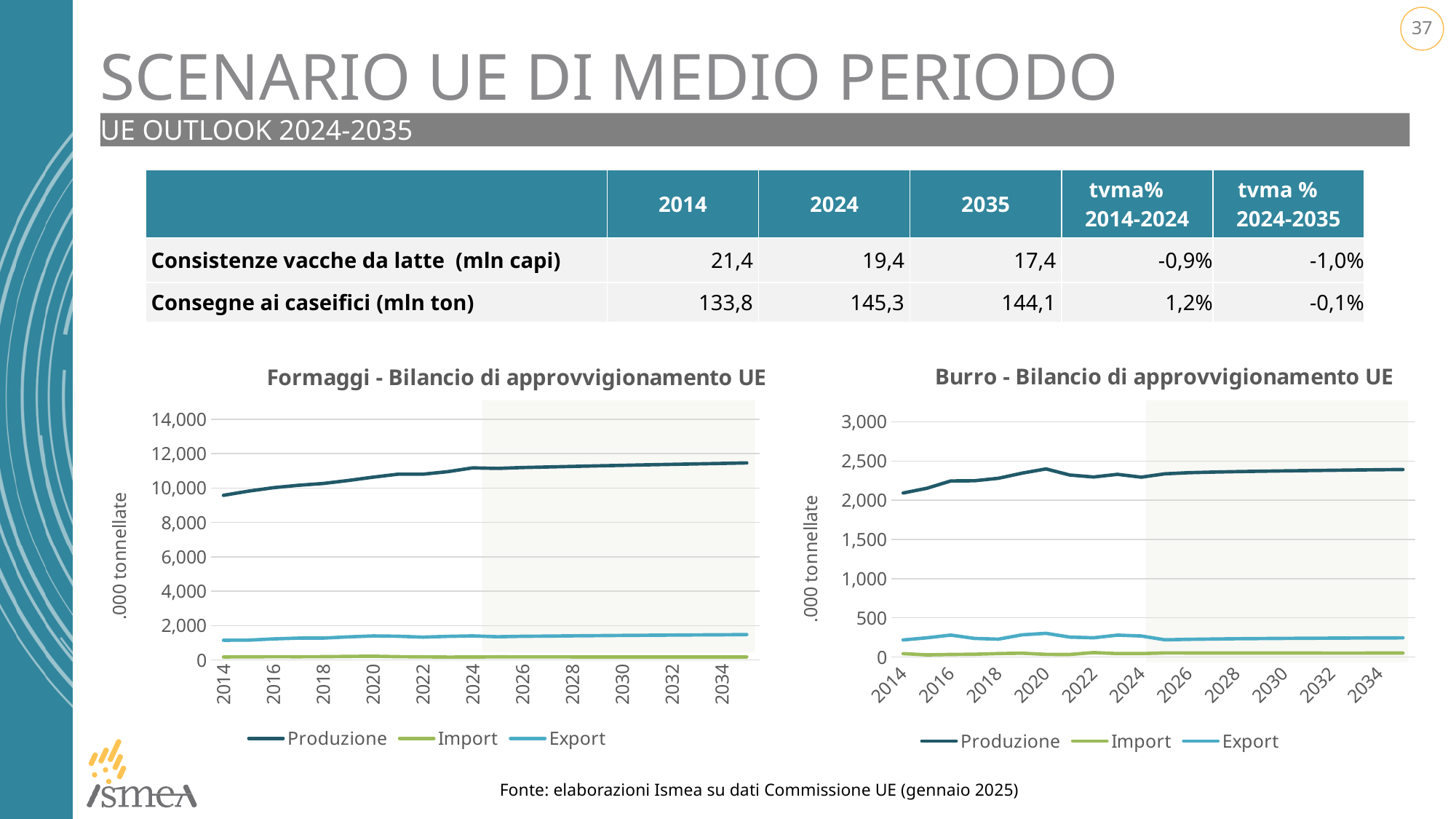
In the 'Formaggi - Bilancio di approvvigionamento UE' chart, is the Produzione value for 2034 greater or less than 10,000? greater In the 'Formaggi - Bilancio di approvvigionamento UE' chart, does the Produzione series rise or fall from 2014 to 2034? rise How many series does the legend of the 'Burro - Bilancio di approvvigionamento UE' chart list? 3 In the 'Burro - Bilancio di approvvigionamento UE' chart, is the Produzione value for 2014 greater or less than 2,500? less In the 'Burro - Bilancio di approvvigionamento UE' chart, which series has the lowest values throughout the period? Import In the 'Formaggi - Bilancio di approvvigionamento UE' chart, is the Produzione value for 2014 greater or less than 10,000? less What is the title of the chart on the left of the slide? Formaggi - Bilancio di approvvigionamento UE In the 'Formaggi - Bilancio di approvvigionamento UE' chart, which series has the highest values throughout the period? Produzione In the 'Formaggi - Bilancio di approvvigionamento UE' chart, which is larger in 2030: Export or Import? Export What is the y-axis label of the 'Burro - Bilancio di approvvigionamento UE' chart? .000 tonnellate What kind of chart is the 'Formaggi - Bilancio di approvvigionamento UE' chart? line chart